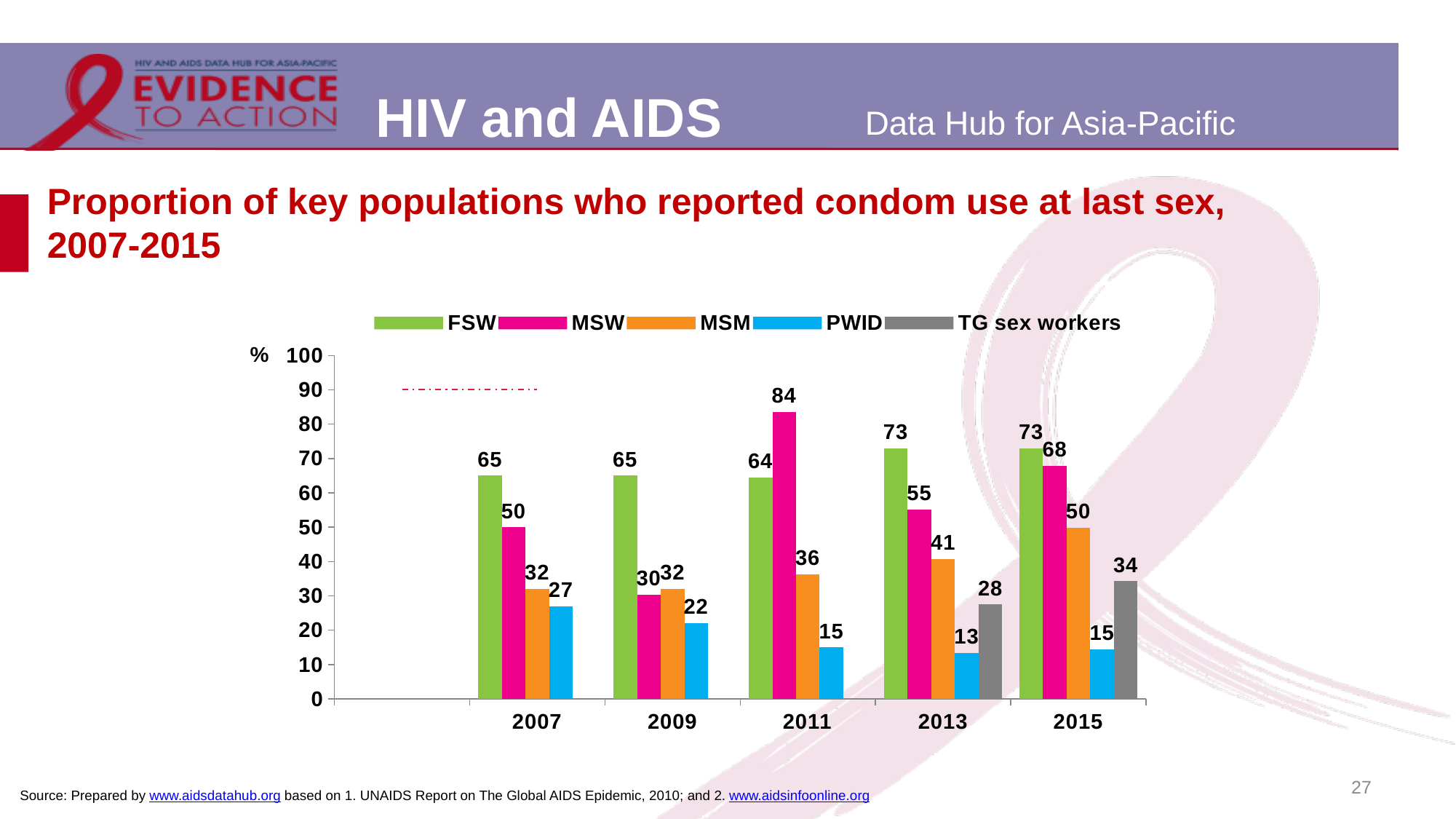
What is the value for MSW in 2011? 84 What is the difference between the FSW and MSW values in 2007? 15 Which is larger: MSM in 2015 or MSW in 2013? MSW in 2013 How many series does the legend list? 5 In which year is the PWID value lowest? 2013 What is the value for PWID in 2013? 13 What kind of chart is shown on the slide? Bar chart What is the value for TG sex workers in 2015? 34 In which year is the MSW value highest? 2011 How many years are shown on the x axis? 5 Which series has bars only for 2013 and 2015? TG sex workers Do the MSM values rise or fall from 2007 to 2015? Rise